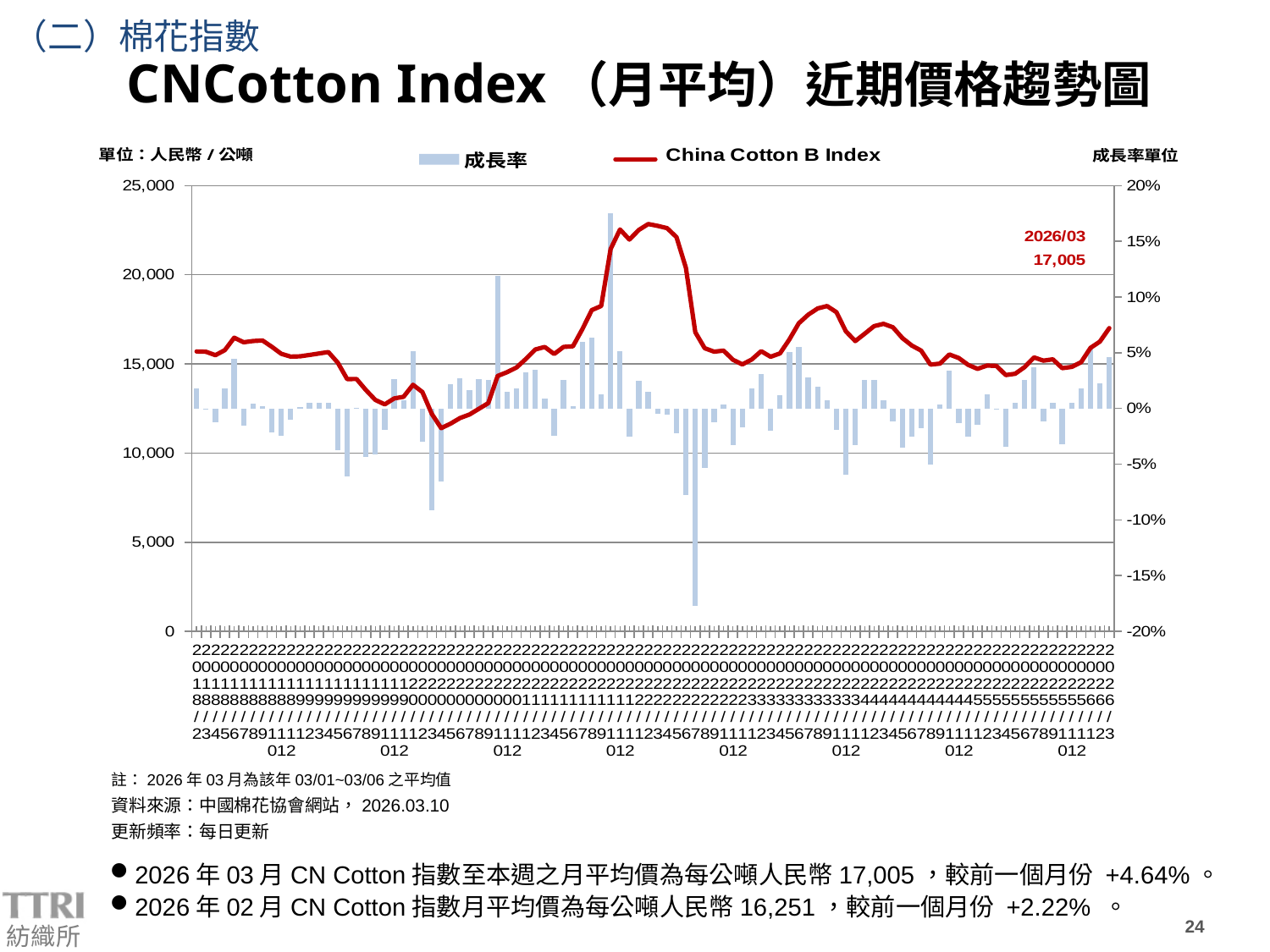
Over the last few months shown on the chart, does the China Cotton B Index line rise or fall? rise What is the maximum value shown on the left vertical axis? 25,000 What kind of chart is this? Combined bar and line chart Which series is drawn as a red line? China Cotton B Index Is the lowest point of the China Cotton B Index line greater or less than 15,000? less Is the lowest 成長率 bar greater or less than -15%? less How many series does the chart legend list? 2 What is the value of the China Cotton B Index labelled for 2026/03? 17,005 Is the China Cotton B Index value for 2026/03 greater or less than 15,000? greater Which series is drawn as light blue bars? 成長率